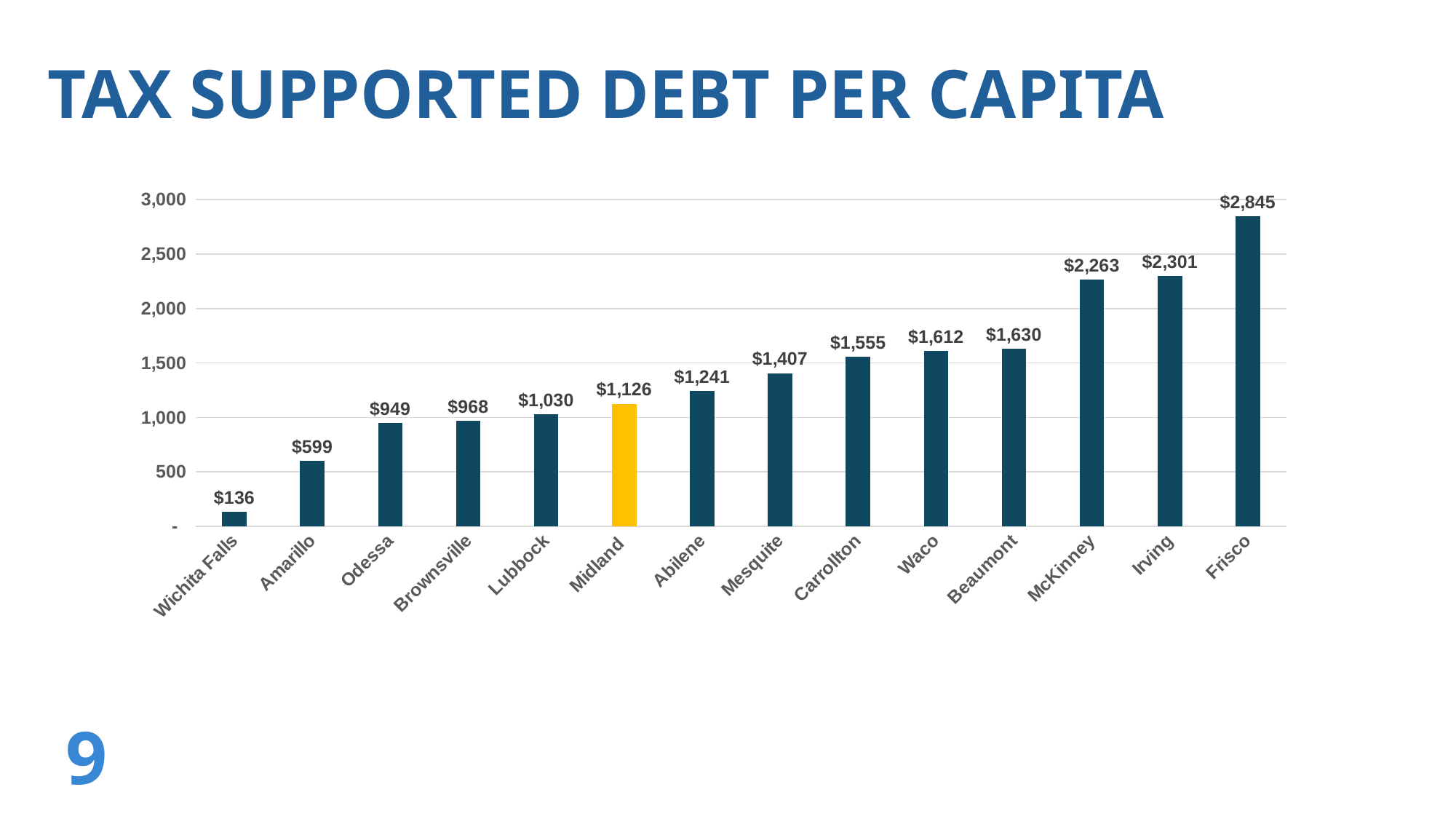
How many cities are shown in the chart? 14 Which city has the lowest tax supported debt per capita? Wichita Falls Do the values rise or fall from left to right along the x axis? Rise What is the difference between the tax supported debt per capita of Frisco and Irving? $544 What is the tax supported debt per capita for Lubbock? $1,030 What is the title of the chart? TAX SUPPORTED DEBT PER CAPITA Which city has a higher tax supported debt per capita, Odessa or Brownsville? Brownsville Is the value for McKinney greater or less than 2,000? greater What kind of chart is shown on the slide? Bar chart Which city has the highest tax supported debt per capita? Frisco What is the tax supported debt per capita for Midland? $1,126 Which city's bar is highlighted in yellow? Midland